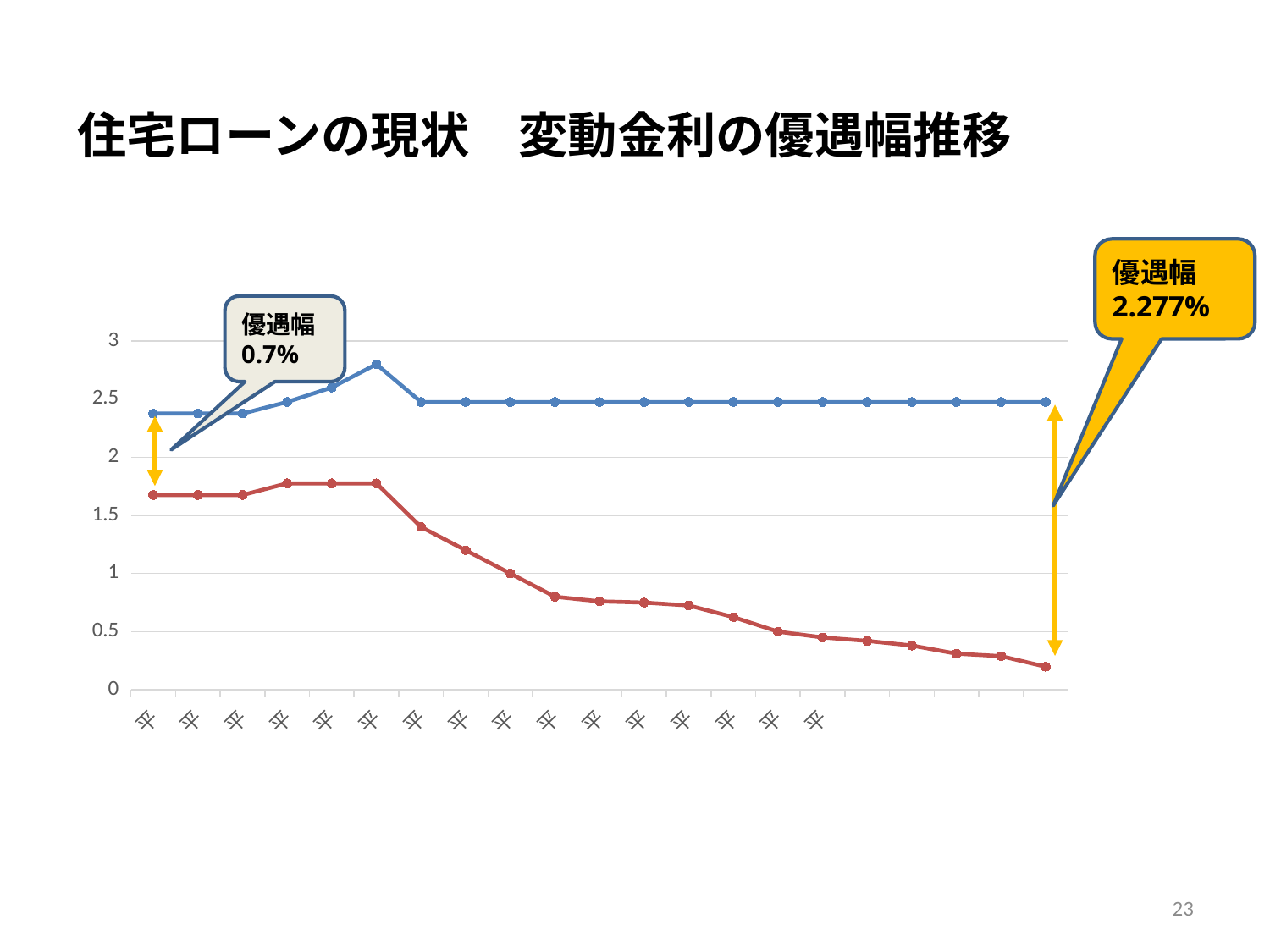
How many data points does each line in the chart have? 21 What is the title of the slide containing the chart? 住宅ローンの現状 変動金利の優遇幅推移 Which point on the red line has the lowest value? the last (rightmost) point What 優遇幅 value is shown in the callout at the left side of the chart? 0.7% Is the highest point on the blue line greater or less than 2.5? greater Does the red line rise or fall from left to right across the chart? fall Is the value of the last point on the blue line greater or less than 2? greater What 優遇幅 value is shown in the callout at the right side of the chart? 2.277% At the rightmost point, which line has the larger value, the blue line or the red line? the blue line What kind of chart is shown on the slide? line chart Is the value of the first point on the red line greater or less than 1.5? greater